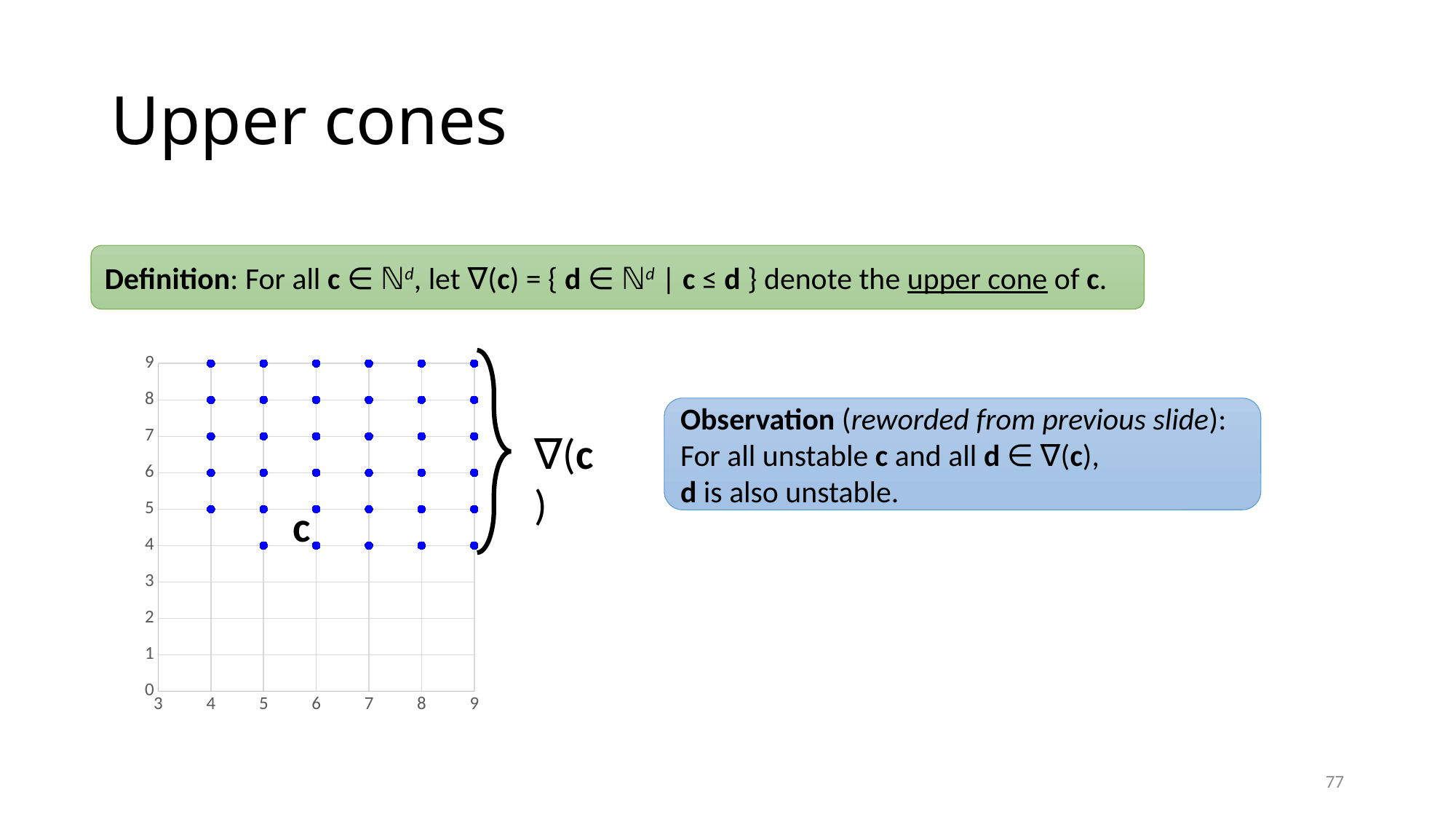
What colour are the plotted points in the chart? blue How many points are plotted along the row y = 4 in the chart? 5 What is the largest x value at which any point is plotted in the chart? 9 What is the smallest y value at which any point is plotted in the chart? 4 How many points are plotted along the row y = 9 in the chart? 6 What kind of chart is shown on the slide? scatter chart Are any points plotted below y = 4 in the chart? No What is the lowest value shown on the x axis of the chart? 3 What is the smallest x value at which any point is plotted in the chart? 4 How many points are plotted along the column x = 9 in the chart? 6 What label is written next to the point at the lower-left corner of the plotted region? c What is the highest value shown on the y axis of the chart? 9